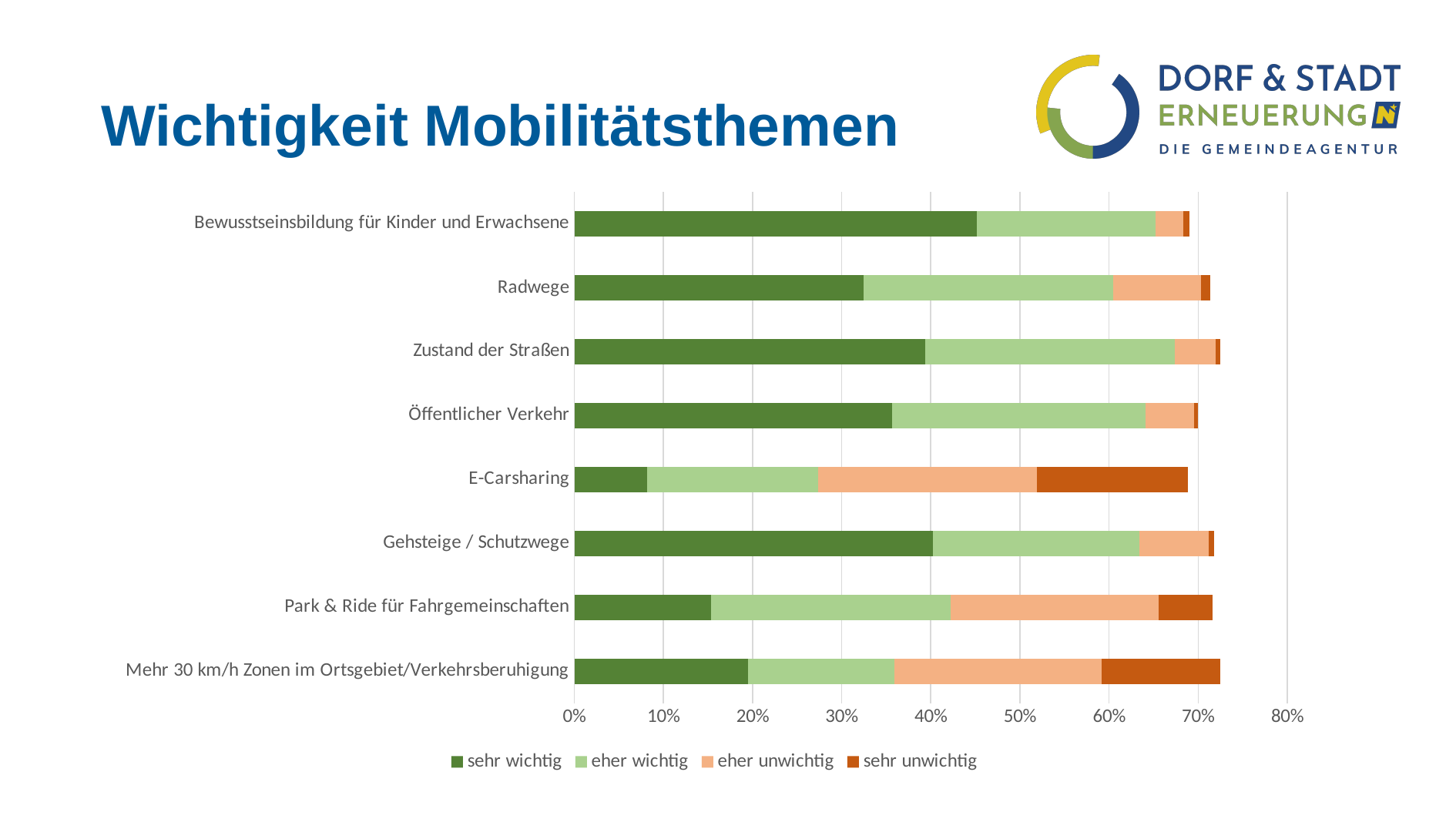
Which has the larger 'sehr wichtig' segment: Gehsteige / Schutzwege or Park & Ride für Fahrgemeinschaften? Gehsteige / Schutzwege Which category has the smallest 'sehr wichtig' segment? E-Carsharing Is the 'sehr wichtig' value for Bewusstseinsbildung für Kinder und Erwachsene greater or less than 40%? greater Which category has the largest 'sehr wichtig' segment? Bewusstseinsbildung für Kinder und Erwachsene How many categories (mobility topics) are listed on the chart? 8 What kind of chart is shown on the slide? stacked bar chart Is the 'sehr wichtig' value for Zustand der Straßen greater or less than 30%? greater Which category has the largest 'sehr unwichtig' segment? E-Carsharing Is the 'sehr wichtig' value for E-Carsharing greater or less than 10%? less How many series does the legend list? 4 What is the title of the slide? Wichtigkeit Mobilitätsthemen